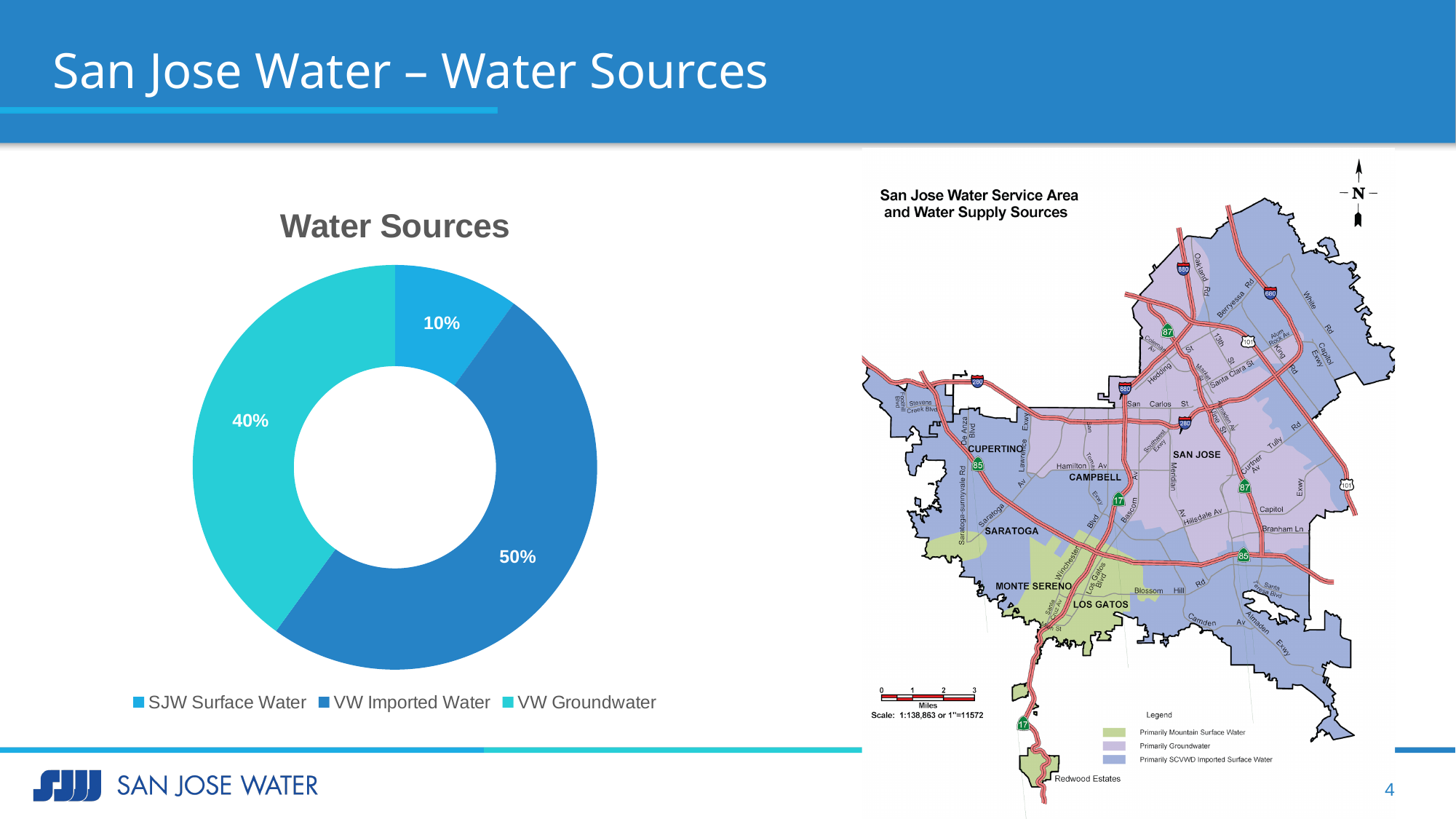
What share of the Water Sources chart is VW Imported Water? 50% What share of the Water Sources chart is SJW Surface Water? 10% Which water source has the smallest share in the Water Sources chart? SJW Surface Water Which water source has the largest share in the Water Sources chart? VW Imported Water In the Water Sources chart, which is larger: VW Groundwater or SJW Surface Water? VW Groundwater How many water sources are shown in the Water Sources chart? 3 In the Water Sources chart, what is the difference between the VW Imported Water share and the VW Groundwater share? 10% In the Water Sources chart, what is the combined share of VW Imported Water and VW Groundwater? 90% Which legend entry in the Water Sources chart is shown in the darkest blue? VW Imported Water What is the title of the chart on the left of the slide? Water Sources What kind of chart is the Water Sources chart? Doughnut chart What share of the Water Sources chart is VW Groundwater? 40%